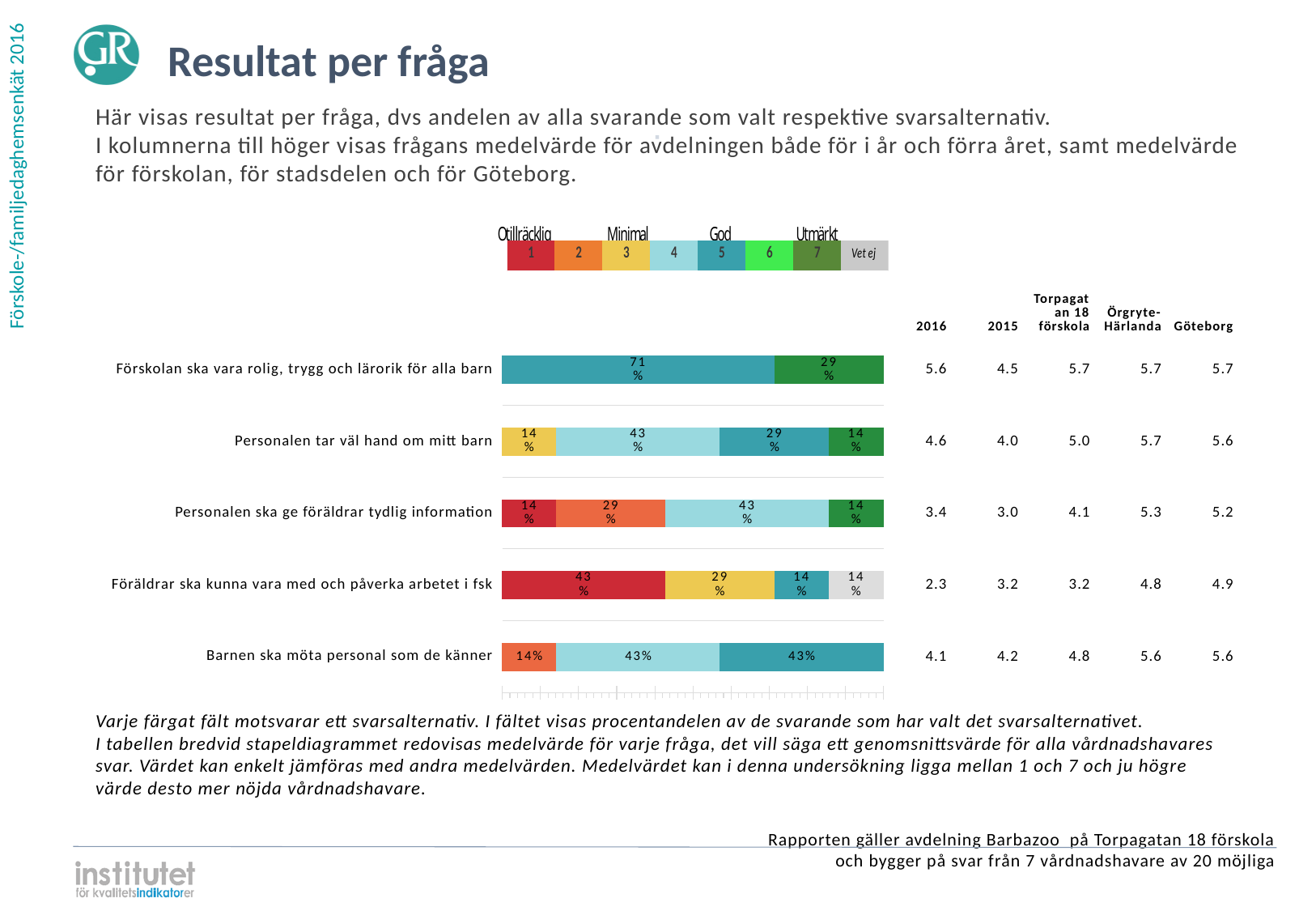
What percentage of respondents chose answer 7 (Utmärkt, dark green) for 'Förskolan ska vara rolig, trygg och lärorik för alla barn'? 29% Which question has the lowest 2016 mean value in the table next to the chart? Föräldrar ska kunna vara med och påverka arbetet i fsk How many answer alternatives does the colour legend above the chart list? 8 What percentage of respondents answered 'Vet ej' (grey) for 'Föräldrar ska kunna vara med och påverka arbetet i fsk'? 14% What percentage of respondents chose answer 1 (Otillräcklig, red) for 'Föräldrar ska kunna vara med och påverka arbetet i fsk'? 43% How many questions (categories) are shown in the bar chart? 5 What is the difference between the 71% segment and the 29% segment for 'Förskolan ska vara rolig, trygg och lärorik för alla barn'? 42 percentage points What is the 2016 mean value for 'Personalen tar väl hand om mitt barn'? 4.6 What kind of chart is used to show the results per question? Stacked bar chart What percentage of respondents chose answer 5 (God, teal) for 'Förskolan ska vara rolig, trygg och lärorik för alla barn'? 71% Which is larger for 'Barnen ska möta personal som de känner': the 2016 mean or the Göteborg mean? Göteborg mean What percentage of respondents chose answer 4 (light blue) for 'Personalen ska ge föräldrar tydlig information'? 43%